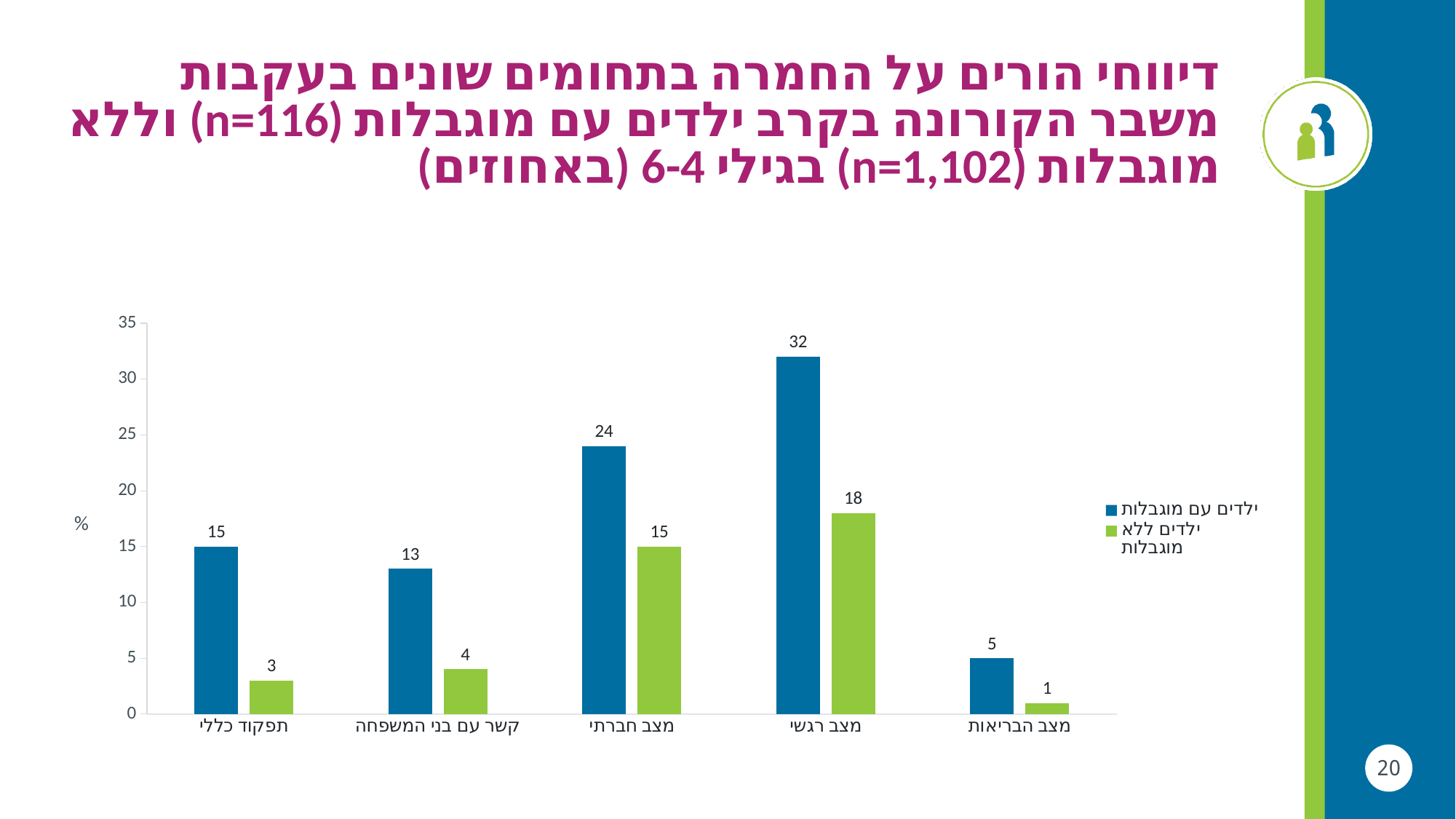
Which category has the highest value for ילדים עם מוגבלות? מצב רגשי Is the value for ילדים עם מוגבלות in the מצב חברתי category greater or less than 20? greater How many categories are shown on the x axis of the chart? 5 What is the value for ילדים ללא מוגבלות in the תפקוד כללי category? 3 What is the value for ילדים עם מוגבלות in the מצב רגשי category? 32 What is the difference between the ילדים עם מוגבלות and ילדים ללא מוגבלות values in the מצב רגשי category? 14 Which colour represents the ילדים ללא מוגבלות series in the chart? green Which category has the lowest value for ילדים ללא מוגבלות? מצב הבריאות In the קשר עם בני המשפחה category, which series has the larger value: ילדים עם מוגבלות or ילדים ללא מוגבלות? ילדים עם מוגבלות How many series does the chart's legend list? 2 What kind of chart is shown on the slide? bar chart What is the value for ילדים ללא מוגבלות in the מצב חברתי category? 15